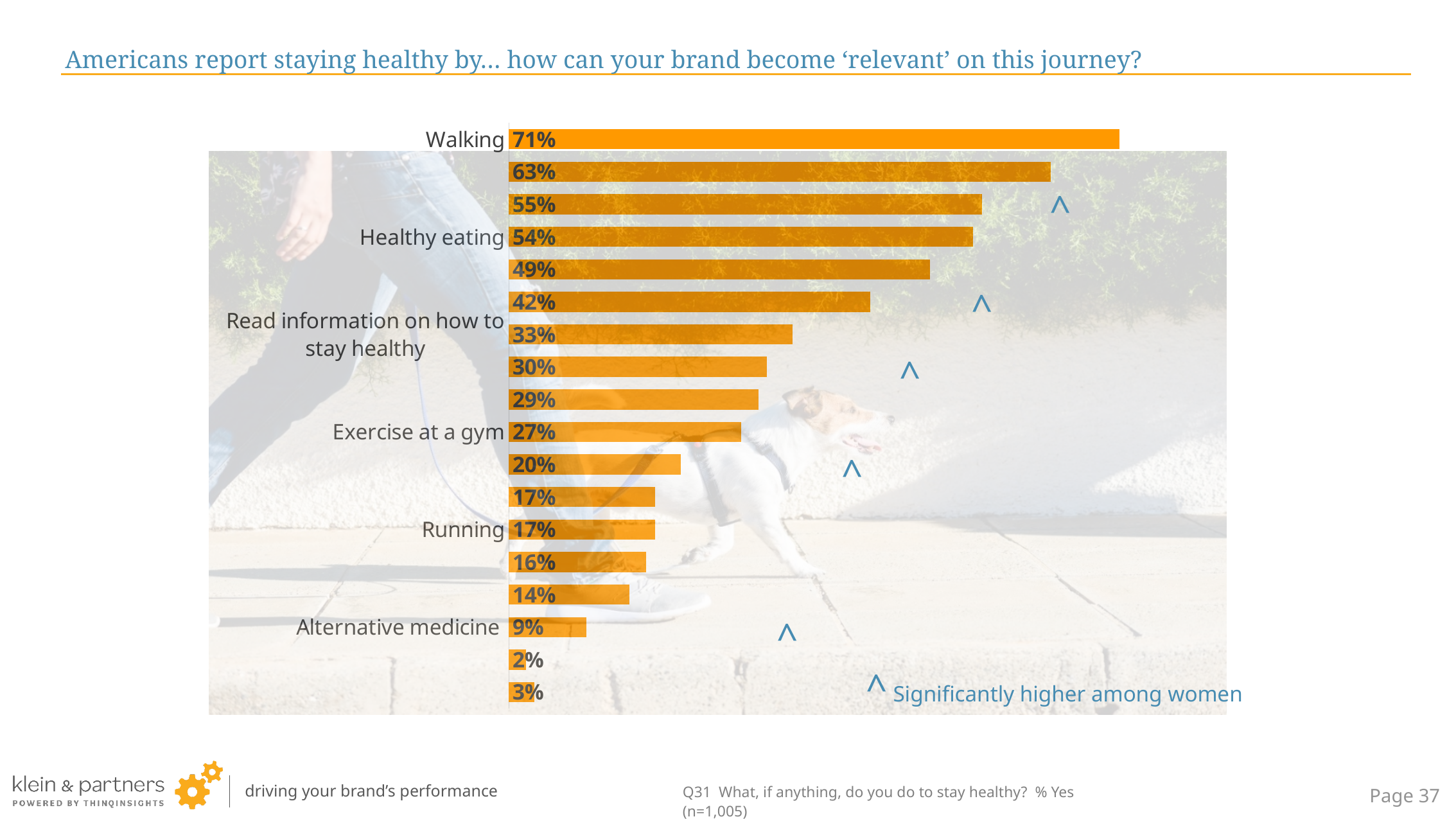
What percentage is shown for Exercise at a gym? 27% What does the ^ symbol next to some bars indicate? Significantly higher among women Which is larger, the value for Healthy eating or the value for Exercise at a gym? Healthy eating What is the value for Read information on how to stay healthy? 33% What is the value for Alternative medicine? 9% What is the value shown for Healthy eating? 54% What is the difference between Running and Alternative medicine? 8 percentage points How many bars are plotted in the chart? 18 What percentage of Americans report walking to stay healthy? 71% What is the smallest value printed on any bar in the chart? 2% Which labelled category has the highest value on the chart? Walking How many percentage points higher is Walking than Healthy eating? 17